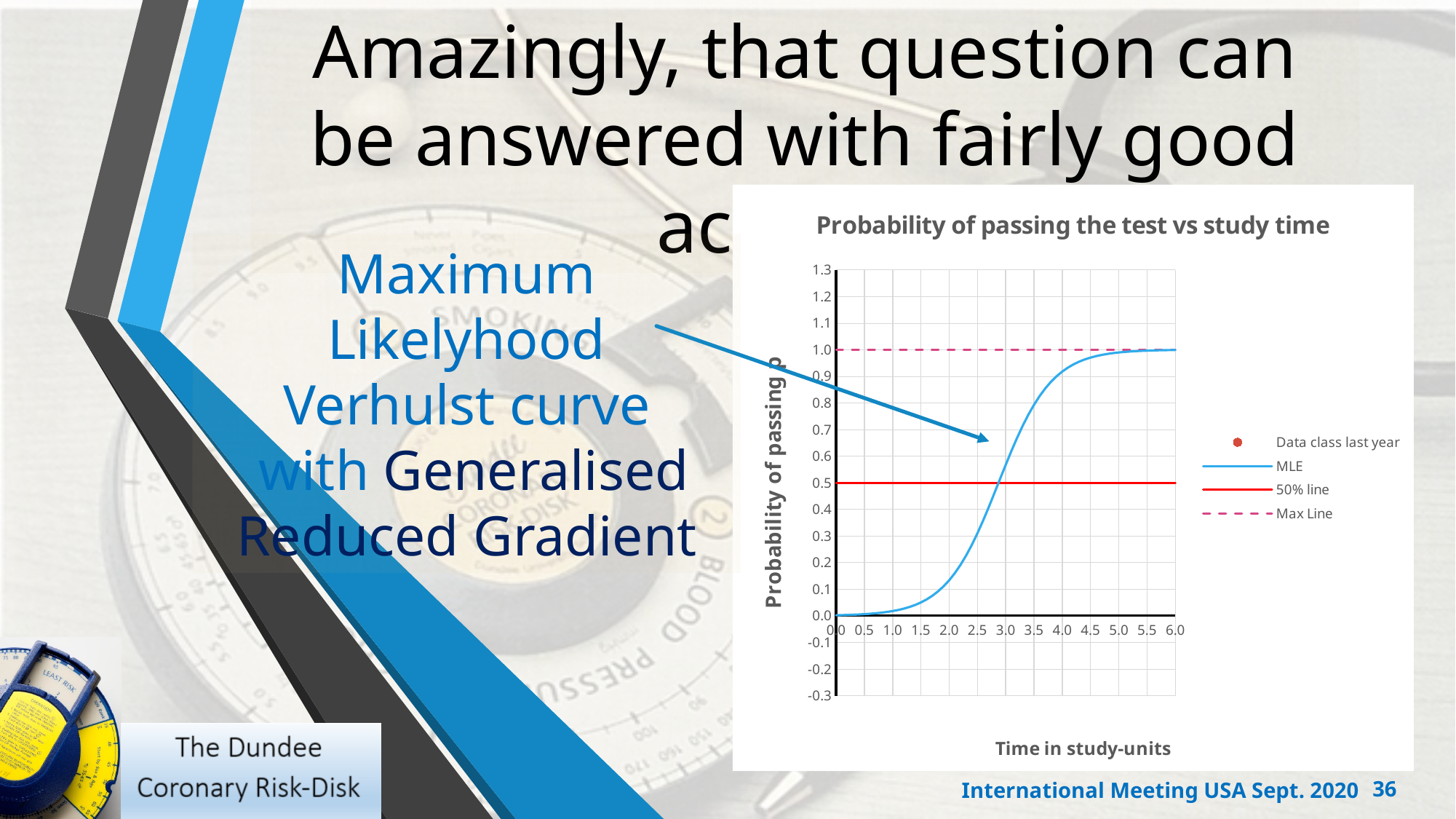
Is the value of the MLE curve at 5.0 study-units greater or less than 0.9? greater At what probability value is the 50% line drawn? 0.5 At what probability value is the Max Line drawn? 1.0 What is the title of the chart? Probability of passing the test vs study time Does the MLE curve rise or fall as time in study-units increases? rises Is the value of the MLE curve at 2.0 study-units greater or less than 0.3? less Is the value of the MLE curve at 1.0 study-units greater or less than 0.5? less How many series does the chart's legend list? 4 What is the label of the x axis of the chart? Time in study-units Which is higher on the chart: the Max Line or the 50% line? Max Line What kind of chart is shown on the slide? line chart At 4.0 study-units, which is higher: the MLE curve or the 50% line? MLE curve